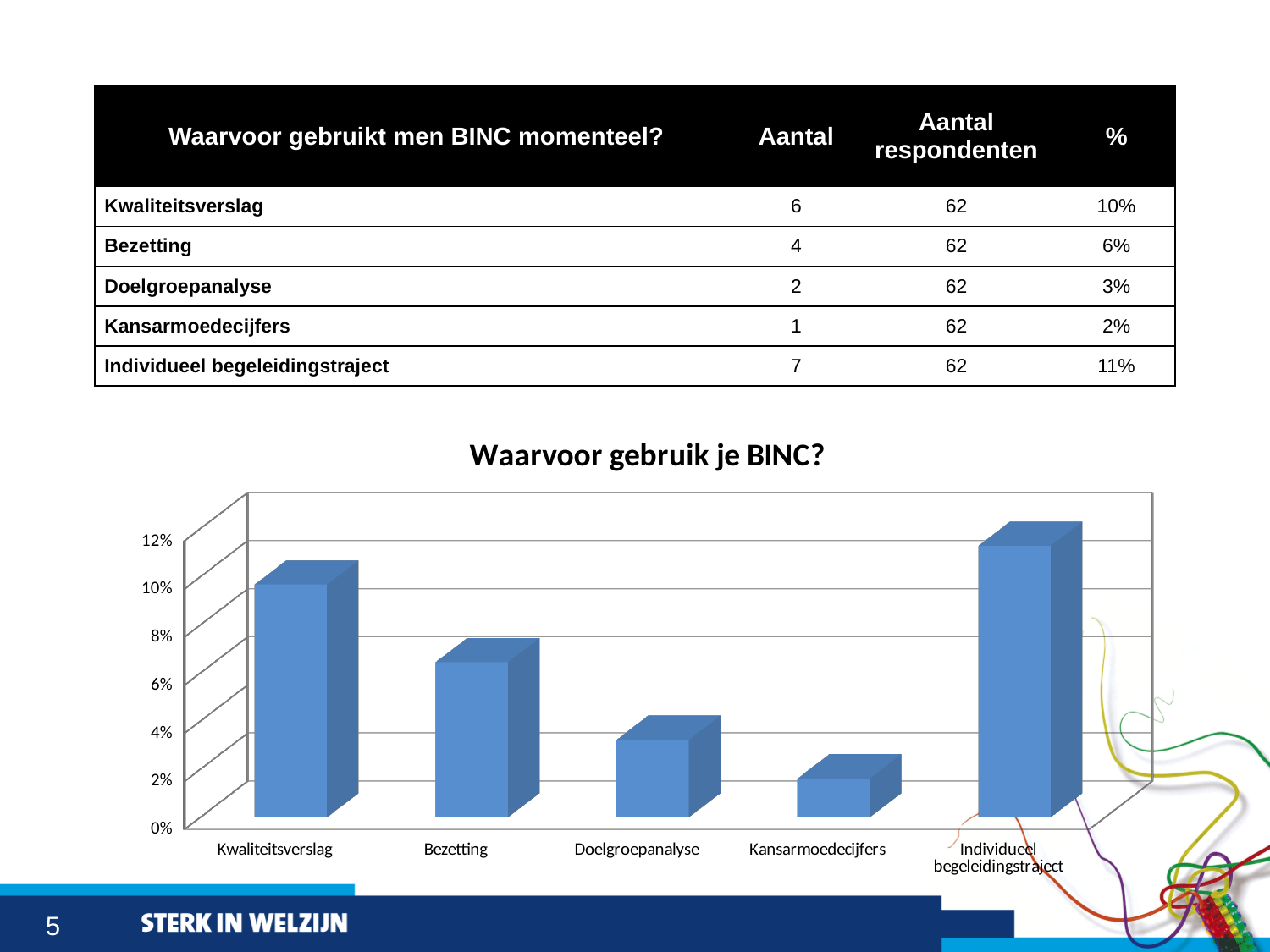
According to the slide, what percentage is shown for Kwaliteitsverslag? 10% According to the slide, what percentage is shown for Individueel begeleidingstraject? 11% What is the title of the chart? Waarvoor gebruik je BINC? Is the value for Individueel begeleidingstraject in the chart greater or less than 10%? greater Which category has the lowest bar in the chart? Kansarmoedecijfers Which is larger in the chart, Bezetting or Doelgroepanalyse? Bezetting What kind of chart is shown on the slide? bar chart Which category has the highest bar in the chart? Individueel begeleidingstraject According to the slide, what percentage is shown for Bezetting? 6% Is the value for Doelgroepanalyse in the chart greater or less than 4%? less What is the difference between the percentages for Kwaliteitsverslag and Bezetting shown on the slide? 4% How many categories are shown on the x axis of the chart? 5